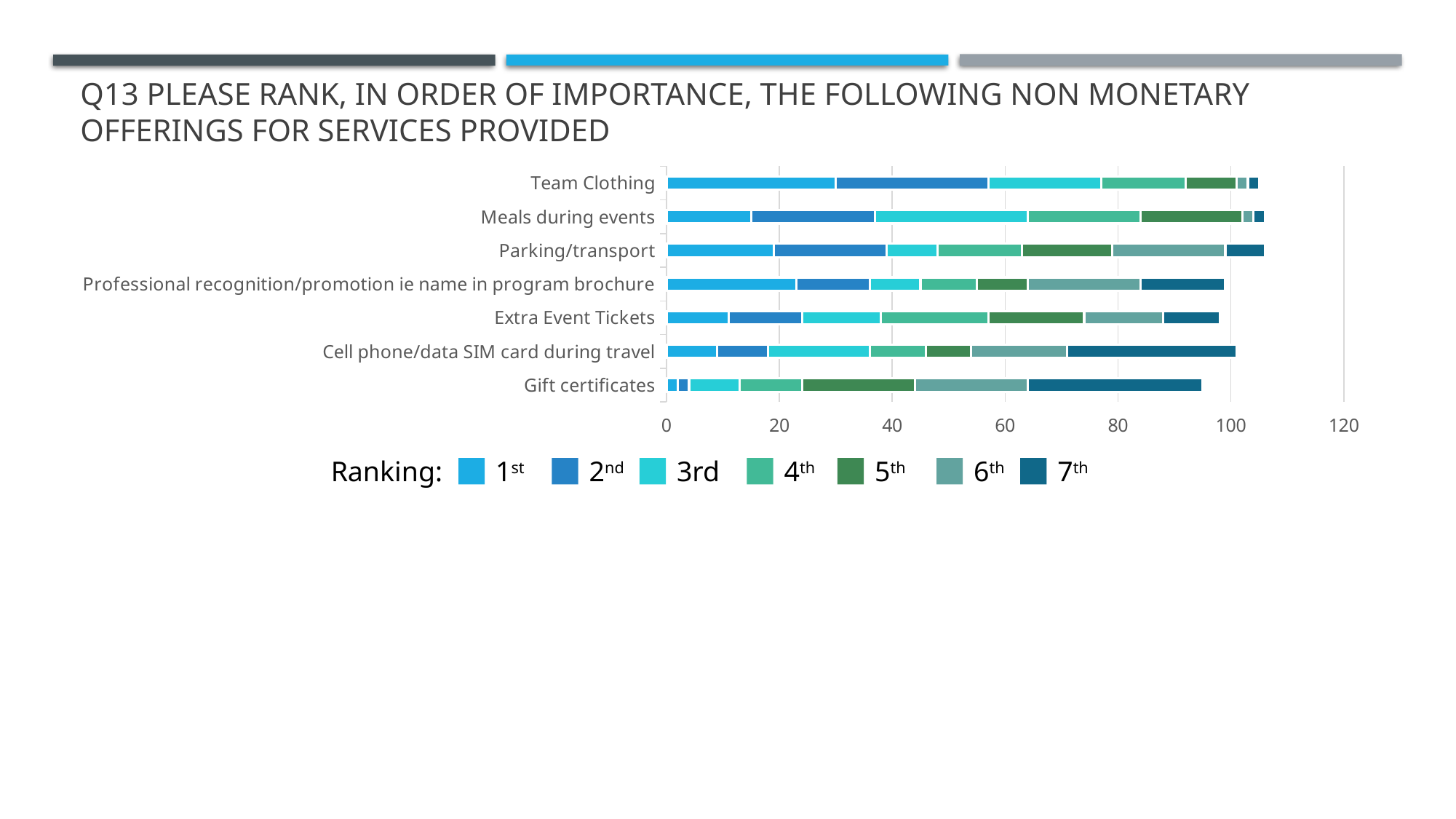
How many non-monetary offerings (categories) are plotted in the chart? 7 How many ranking series does the legend list? 7 Is the total bar length for Gift certificates greater or less than 100? less Is the total bar length for Parking/transport greater or less than 100? greater Is the 1st-ranking segment for Team Clothing greater or less than 20? greater Which has the larger 1st-ranking segment, Team Clothing or Gift certificates? Team Clothing What kind of chart is shown on the slide? Stacked bar chart Which has the larger 7th-ranking segment, Gift certificates or Team Clothing? Gift certificates Which category has the largest 1st-ranking segment? Team Clothing Which category is listed at the top of the chart? Team Clothing What label precedes the legend entries below the chart? Ranking: